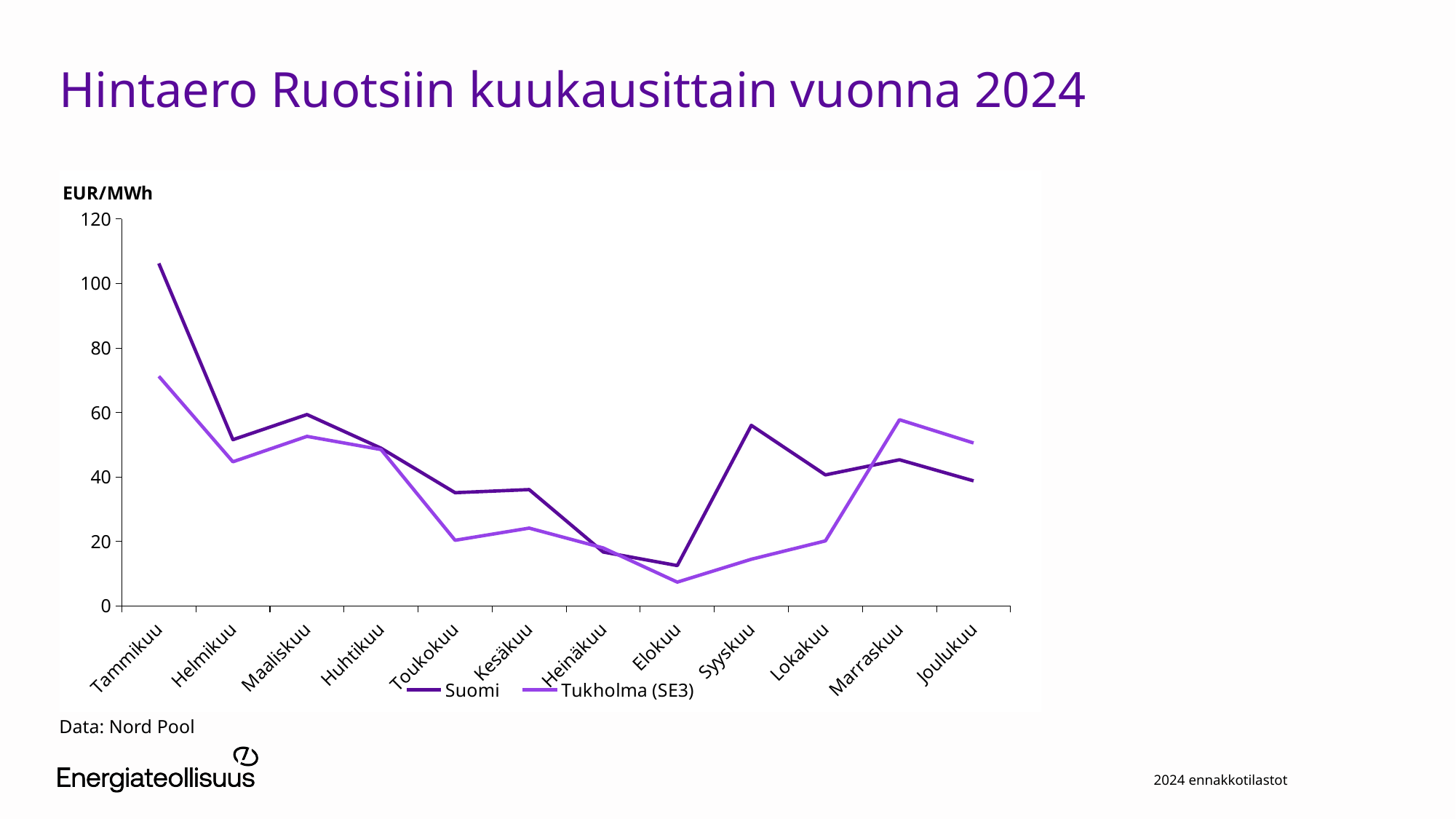
Does the Suomi series rise or fall from Tammikuu to Helmikuu? fall How many months are plotted along the x axis? 12 What unit is shown on the y axis of the chart? EUR/MWh In which month does the Suomi series reach its highest value? Tammikuu How many series does the legend list? 2 Is the value for Suomi in Tammikuu greater or less than 100? greater What kind of chart is shown on the slide? line chart Is the value for Tukholma (SE3) in Elokuu greater or less than 20? less Is the value for Suomi in Syyskuu greater or less than 40? greater In Tammikuu, which series has the higher value, Suomi or Tukholma (SE3)? Suomi In which month does the Tukholma (SE3) series reach its lowest value? Elokuu In Marraskuu, which series has the higher value, Suomi or Tukholma (SE3)? Tukholma (SE3)